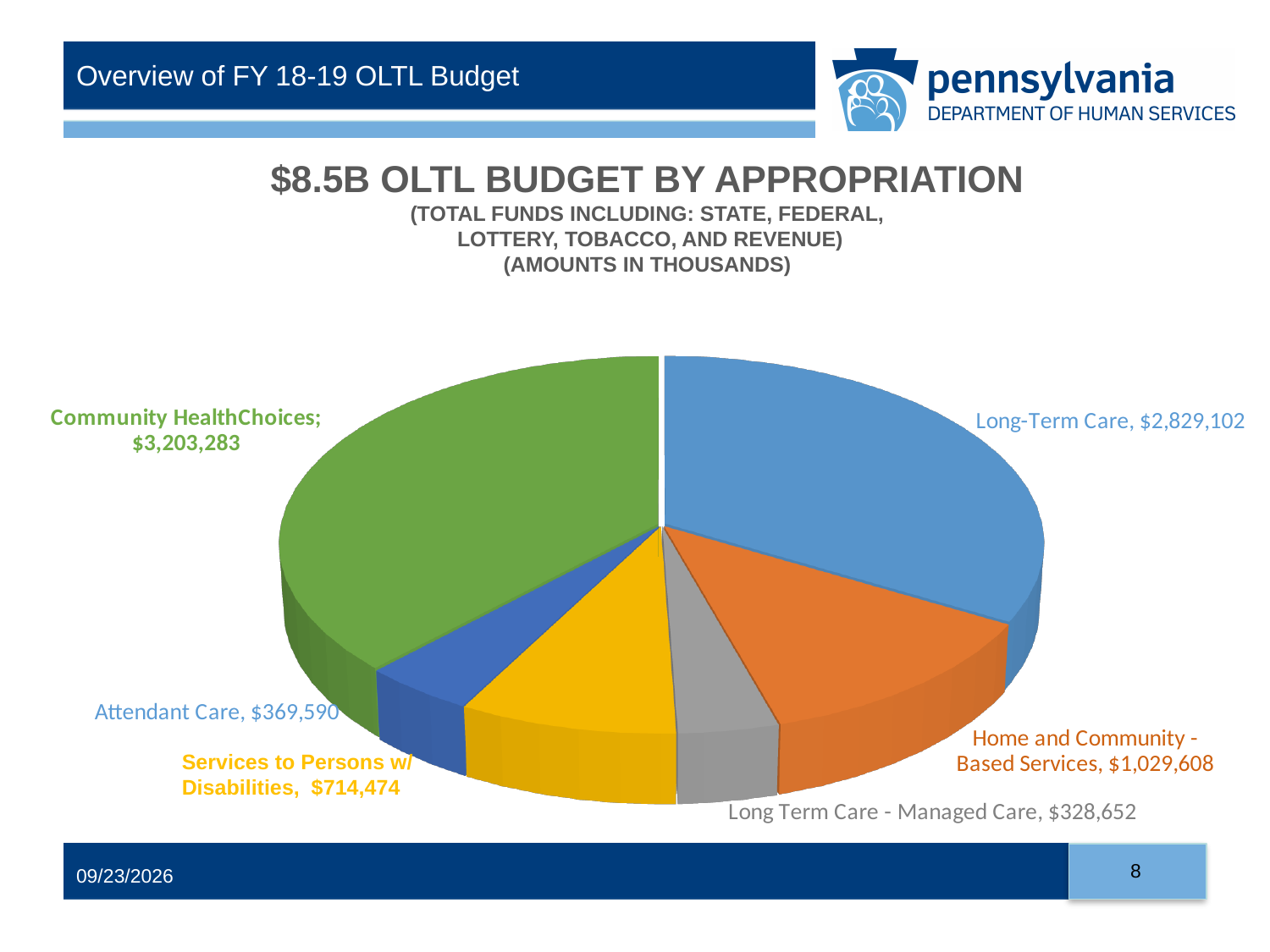
What is the value for Home and Community-Based Services? $1,029,608 What is the title of the chart? $8.5B OLTL BUDGET BY APPROPRIATION Which appropriation has the largest slice of the pie? Community HealthChoices Which appropriation has the smallest slice of the pie? Long Term Care - Managed Care What type of chart is shown on the slide? Pie chart What is the value for Long-Term Care? $2,829,102 What is the value for Attendant Care? $369,590 What is the value for Community HealthChoices? $3,203,283 What is the difference between Community HealthChoices and Long-Term Care? $374,181 What is the value for Long Term Care - Managed Care? $328,652 Which is larger, Attendant Care or Long Term Care - Managed Care? Attendant Care How many slices does the pie chart have? 6